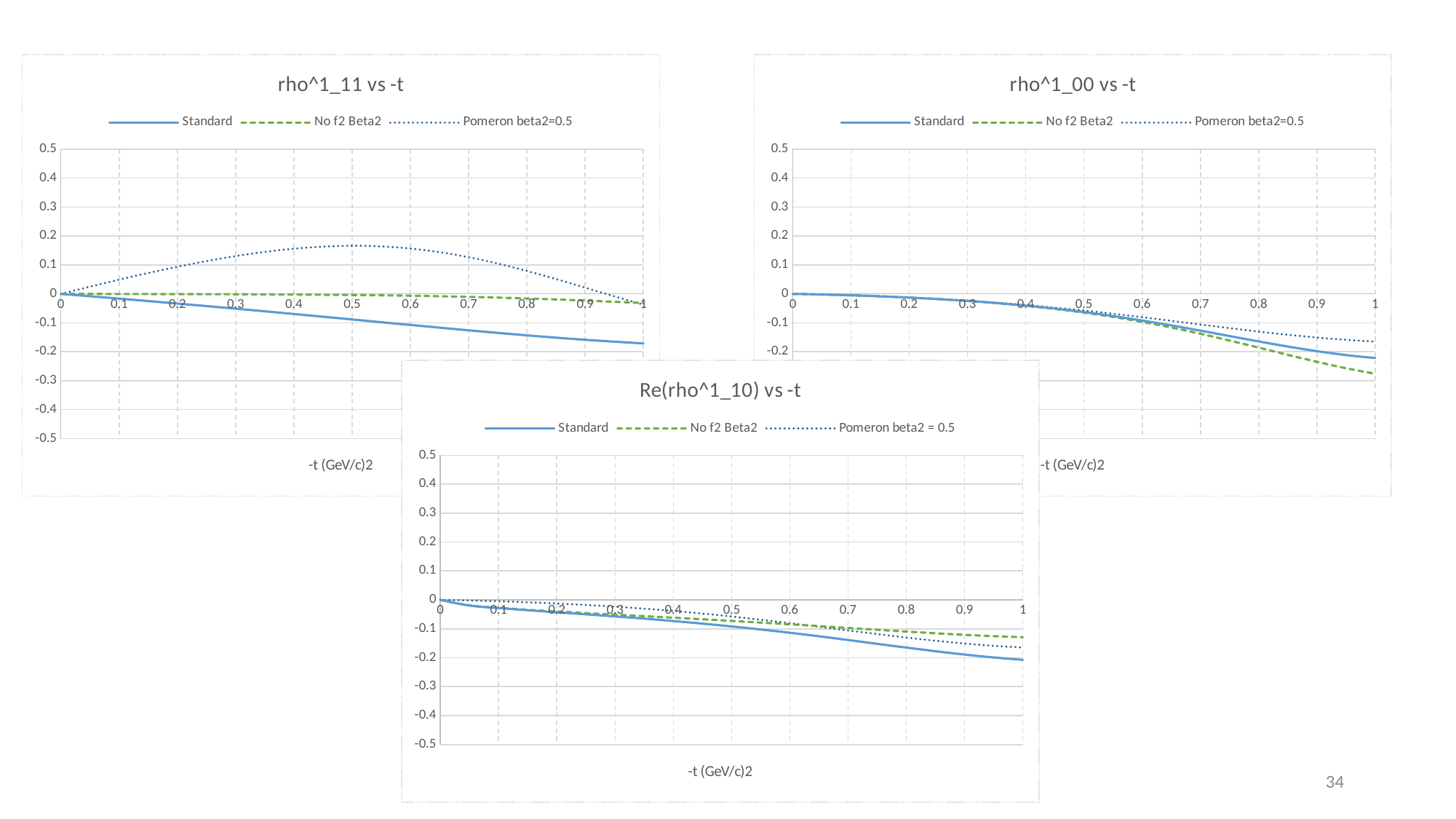
In "rho^1_11 vs -t", is the value of the Standard series at -t = 1 greater or less than -0.1? less How many charts are shown on the slide? 3 What is the x-axis label of the "Re(rho^1_10) vs -t" chart? -t (GeV/c)2 In "Re(rho^1_10) vs -t", which is larger at -t = 1: the Standard series or the No f2 Beta2 series? No f2 Beta2 What kind of chart is "rho^1_11 vs -t"? line chart In "rho^1_00 vs -t", is the value of the No f2 Beta2 series at -t = 1 greater or less than -0.2? less In "rho^1_11 vs -t", which series has the highest value at -t = 0.5? Pomeron beta2=0.5 In "rho^1_00 vs -t", does the Standard series rise or fall as -t increases from 0 to 1? fall In "rho^1_11 vs -t", is the value of the Pomeron beta2=0.5 series at -t = 0.5 greater or less than 0.1? greater In "rho^1_00 vs -t", which series has the lowest value at -t = 1? No f2 Beta2 How many series does the legend of "rho^1_00 vs -t" list? 3